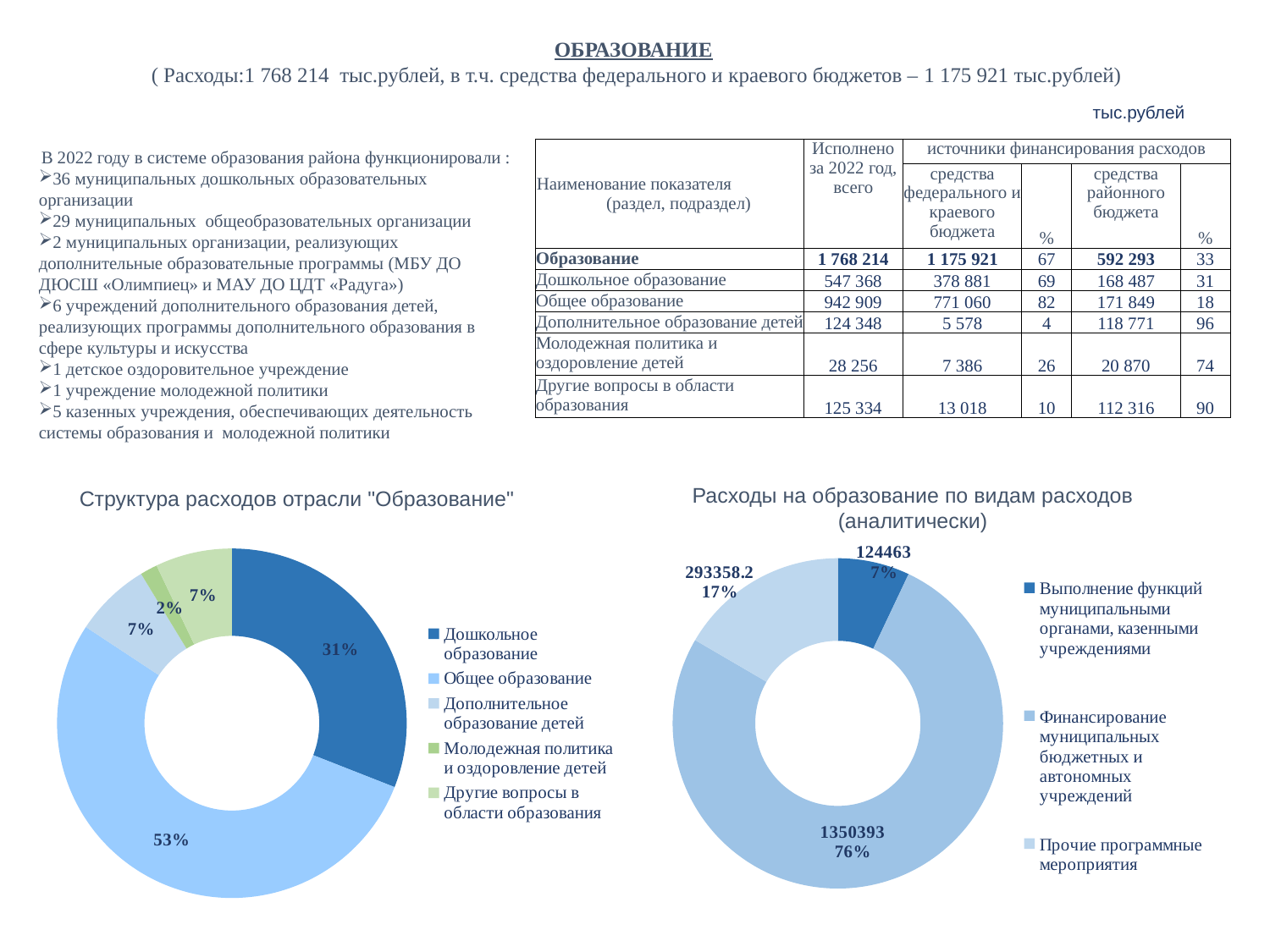
In the chart "Структура расходов отрасли "Образование"", which category has the smallest share? Молодежная политика и оздоровление детей In the chart "Расходы на образование по видам расходов (аналитически)", what share does Прочие программные мероприятия have? 17% In the chart "Структура расходов отрасли "Образование"", what share does Дошкольное образование have? 31% In the chart "Структура расходов отрасли "Образование"", what is the difference in percentage points between Общее образование and Дошкольное образование? 22 percentage points In the chart "Структура расходов отрасли "Образование"", which category has the largest share? Общее образование In the chart "Структура расходов отрасли "Образование"", how many categories does the legend list? 5 In the chart "Расходы на образование по видам расходов (аналитически)", which category has the largest share? Финансирование муниципальных бюджетных и автономных учреждений In the chart "Структура расходов отрасли "Образование"", what share does Общее образование have? 53% In the chart "Расходы на образование по видам расходов (аналитически)", what is the value for Выполнение функций муниципальными органами, казенными учреждениями? 124463 In the chart "Расходы на образование по видам расходов (аналитически)", what is the value for Финансирование муниципальных бюджетных и автономных учреждений? 1350393 In the chart "Структура расходов отрасли "Образование"", what share does Молодежная политика и оздоровление детей have? 2% What kind of chart is "Расходы на образование по видам расходов (аналитически)"? Doughnut (pie) chart